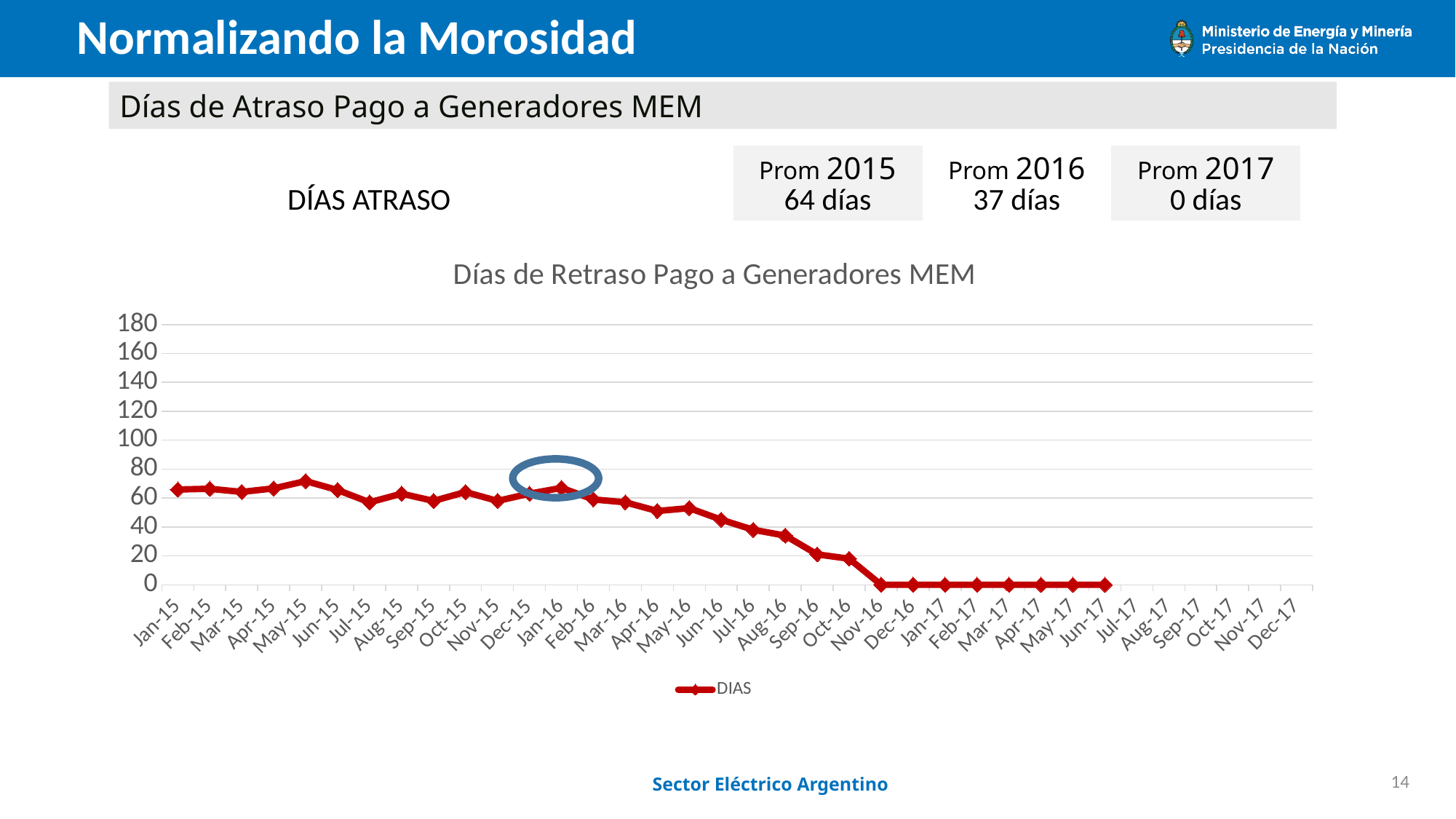
Is the value for May-15 greater or less than 60? greater What is the value for Nov-16? 0 What is the value for Jun-17? 0 Is the value for Aug-16 greater or less than 40? less What is the name of the series shown in the chart legend? DIAS Which month has the highest value in the chart? May-15 Is the value for Jun-16 greater or less than 40? greater What is the title of the chart? Días de Retraso Pago a Generadores MEM Which is larger, the value for Jan-15 or the value for Sep-16? Jan-15 How many series does the chart legend list? 1 What kind of chart is shown on the slide? Line chart Do the values generally rise or fall from Jan-15 to Jun-17? Fall